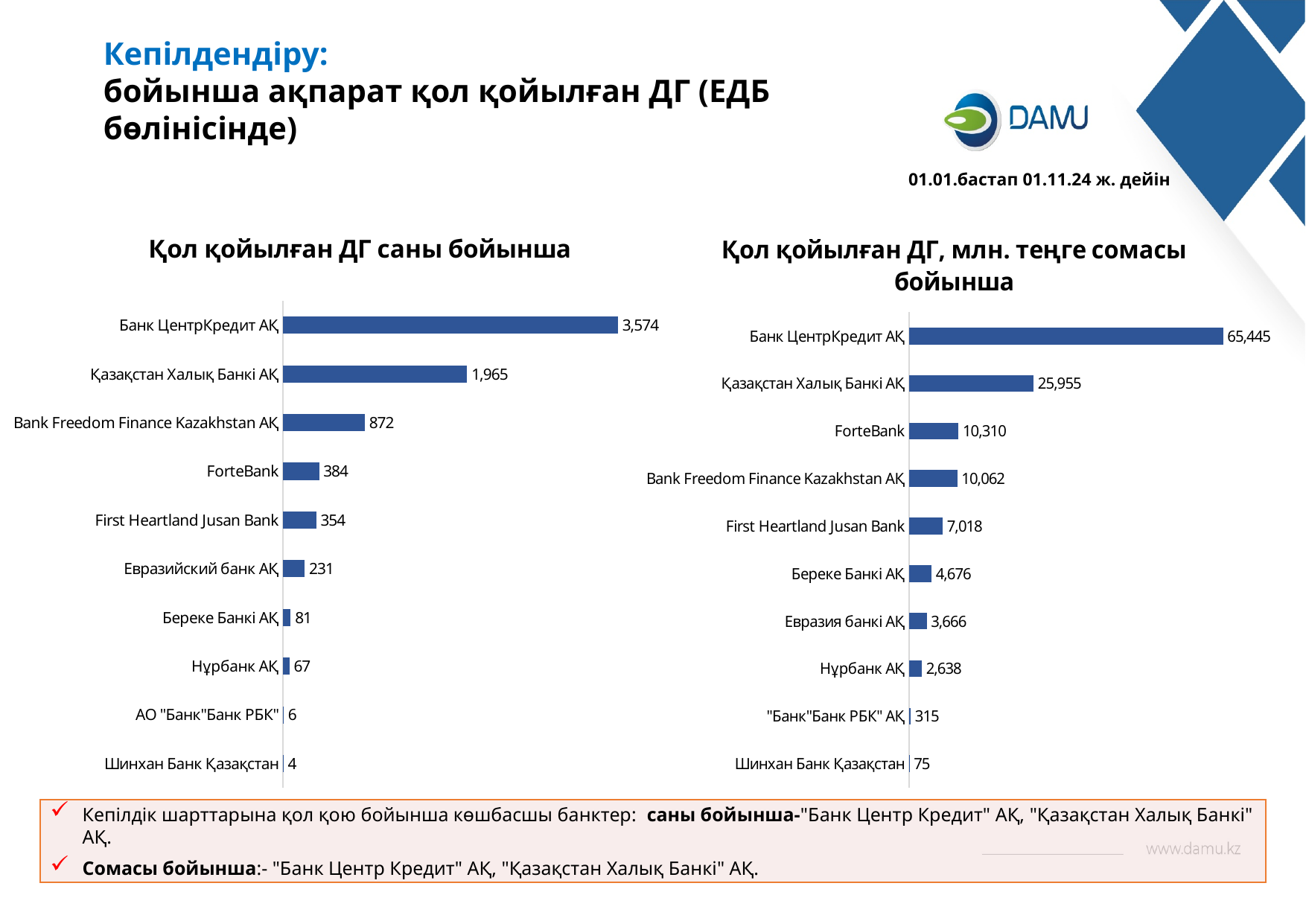
How many banks are shown in the right chart 'Қол қойылған ДГ, млн. теңге сомасы бойынша'? 10 In the left chart 'Қол қойылған ДГ саны бойынша', what is the value for Банк ЦентрКредит АҚ? 3,574 In the right chart 'Қол қойылған ДГ, млн. теңге сомасы бойынша', what is the value for Қазақстан Халық Банкі АҚ? 25,955 In the right chart 'Қол қойылған ДГ, млн. теңге сомасы бойынша', which bank has the highest value? Банк ЦентрКредит АҚ In the right chart 'Қол қойылған ДГ, млн. теңге сомасы бойынша', what is the value for Нұрбанк АҚ? 2,638 In the left chart 'Қол қойылған ДГ саны бойынша', what is the difference between Банк ЦентрКредит АҚ and Қазақстан Халық Банкі АҚ? 1,609 In the left chart 'Қол қойылған ДГ саны бойынша', which is larger: Bank Freedom Finance Kazakhstan АҚ or First Heartland Jusan Bank? Bank Freedom Finance Kazakhstan АҚ What is the title of the right chart on the slide? Қол қойылған ДГ, млн. теңге сомасы бойынша What type of chart is the left chart 'Қол қойылған ДГ саны бойынша'? Bar chart In the right chart 'Қол қойылған ДГ, млн. теңге сомасы бойынша', what is the difference between ForteBank and Bank Freedom Finance Kazakhstan АҚ? 248 In the left chart 'Қол қойылған ДГ саны бойынша', which bank has the lowest value? Шинхан Банк Қазақстан In the left chart 'Қол қойылған ДГ саны бойынша', what is the value for ForteBank? 384